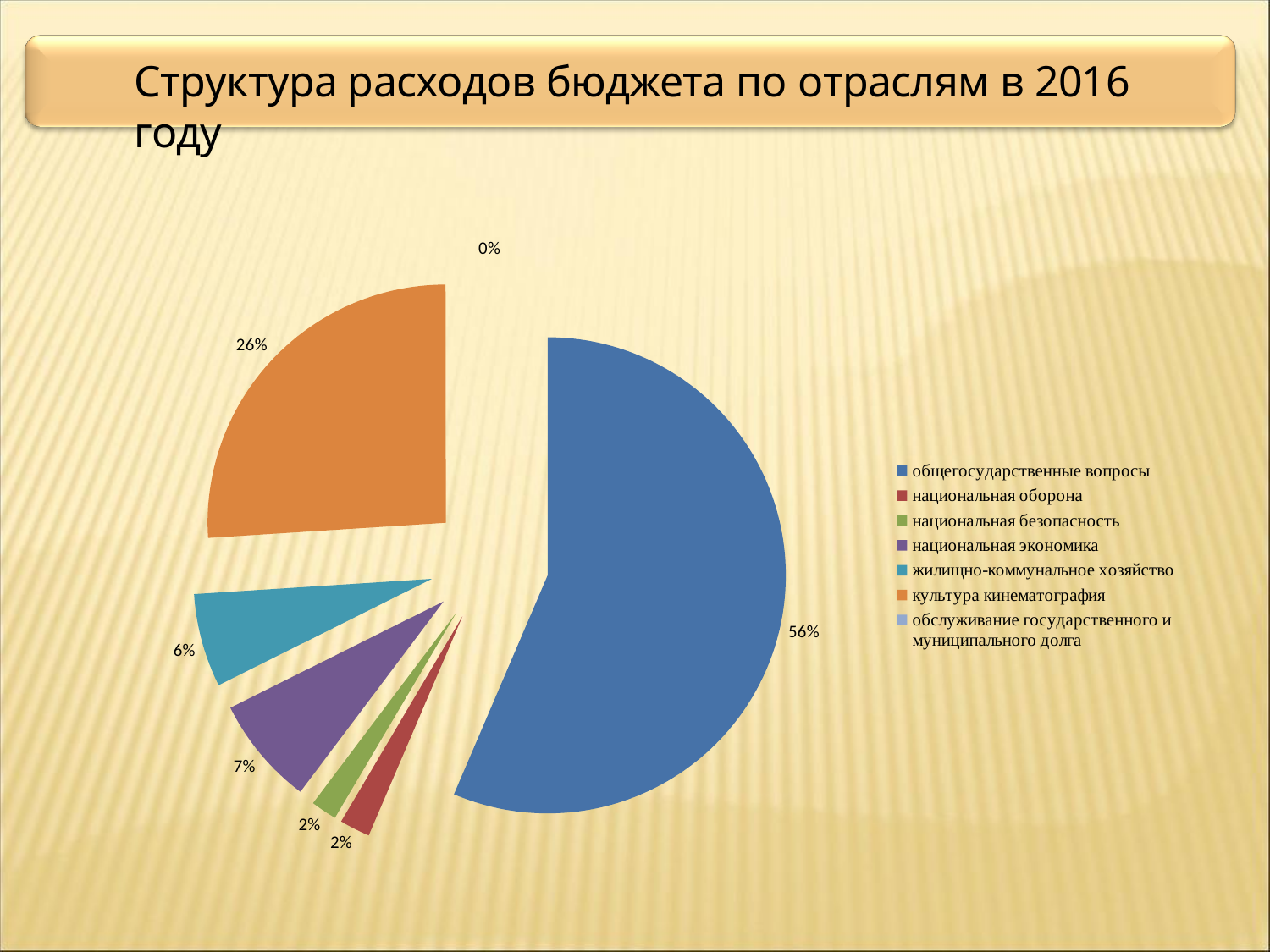
What is the value shown for "национальная экономика"? 7% How many categories does the legend list? 7 What share of the pie does "общегосударственные вопросы" take? 56% What share of the pie does "культура кинематография" take? 26% What is the title of the slide? Структура расходов бюджета по отраслям в 2016 году What is the value shown for "обслуживание государственного и муниципального долга"? 0% Which category has the largest slice of the pie? общегосударственные вопросы Which category has the smallest slice of the pie? обслуживание государственного и муниципального долга What is the value shown for "жилищно-коммунальное хозяйство"? 6% What is the difference between the shares of "общегосударственные вопросы" and "культура кинематография"? 30% Which is larger, the share for "национальная экономика" or the share for "жилищно-коммунальное хозяйство"? национальная экономика What kind of chart is shown on the slide? pie chart